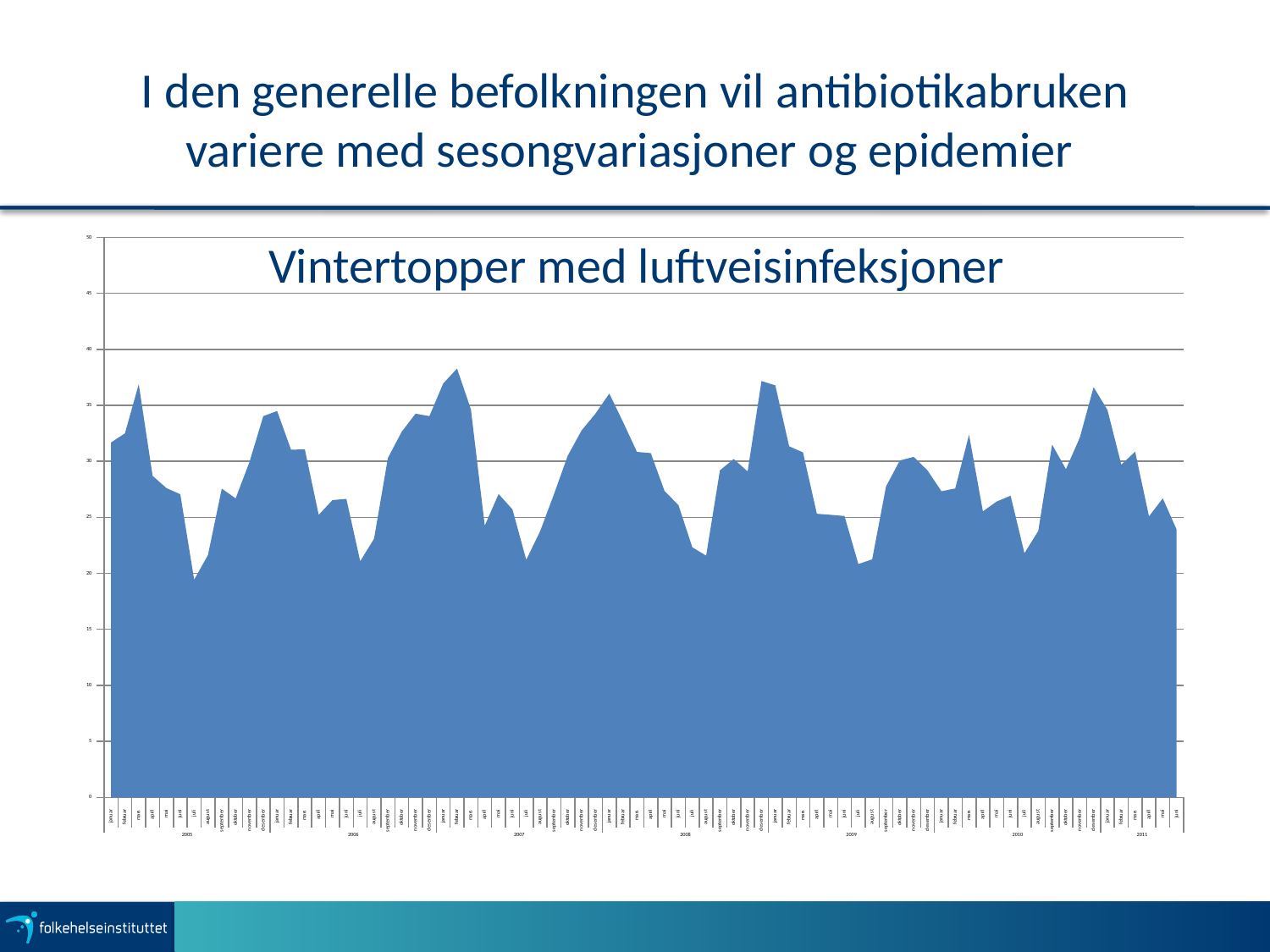
How many years are labelled along the x axis of the chart? 7 Is the lowest point of the chart in 2008 greater or less than 25? less Is the highest point of the chart in 2007 greater or less than 35? greater Is the lowest point of the chart in 2005 greater or less than 25? less Which year is the last labelled on the x axis of the chart? 2011 What kind of chart is shown on the slide? Area chart Do the values on the chart rise steadily, fall steadily, or fluctuate seasonally across the years? Fluctuate seasonally What is the title of the chart? Vintertopper med luftveisinfeksjoner What is the highest value shown on the chart's y axis? 50 Which year is the first labelled on the x axis of the chart? 2005